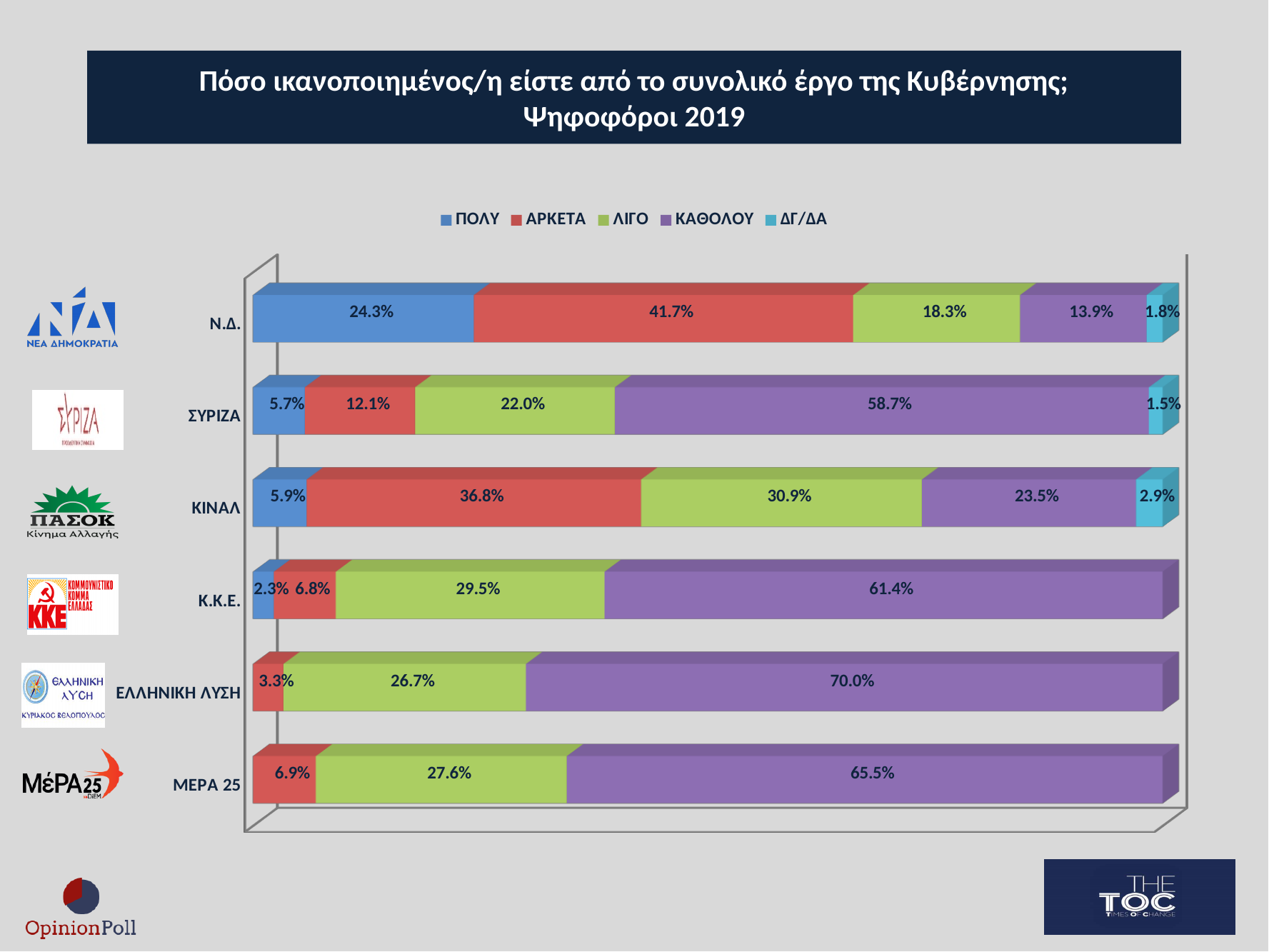
What is the ΚΑΘΟΛΟΥ value for ΣΥΡΙΖΑ voters? 58.7% What is the difference between the ΑΡΚΕΤΑ values for Ν.Δ. and ΚΙΝΑΛ voters? 4.9% What is the ΛΙΓΟ value for ΚΙΝΑΛ voters? 30.9% How many series does the legend list? 5 What kind of chart is shown on the slide? Stacked bar chart What is the total of the ΠΟΛΥ and ΑΡΚΕΤΑ values for Ν.Δ. voters? 66.0% Which party's voters have the highest ΚΑΘΟΛΟΥ value? ΕΛΛΗΝΙΚΗ ΛΥΣΗ What percentage of Ν.Δ. voters answered ΠΟΛΥ? 24.3% How many parties (categories) are shown in the chart? 6 What is the ΔΓ/ΔΑ value for ΚΙΝΑΛ voters? 2.9% Which is larger: the ΚΑΘΟΛΟΥ value for Κ.Κ.Ε. voters or for ΜΕΡΑ 25 voters? ΜΕΡΑ 25